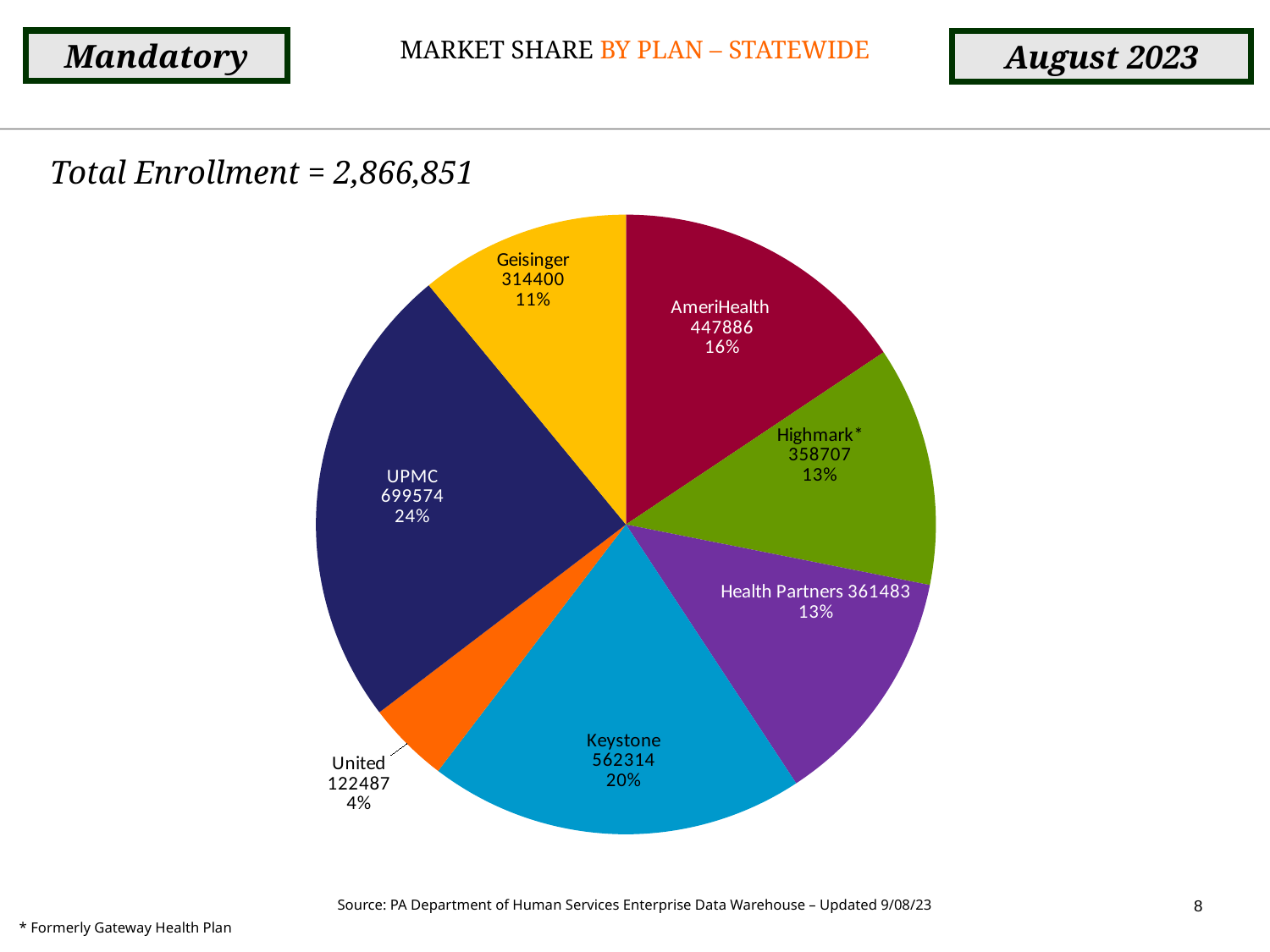
What total enrollment figure is stated above the chart? 2,866,851 How many plans (slices) are shown in the pie chart? 7 What is the difference between the enrollment values for UPMC and Keystone? 137260 What percentage share of the pie does Geisinger have? 11% What percentage share of the pie does AmeriHealth have? 16% Which plan has the largest share of the pie? UPMC What is the enrollment value shown for UPMC? 699574 Which has a larger enrollment value, Keystone or AmeriHealth? Keystone What is the enrollment value shown for Health Partners? 361483 What is the enrollment value shown for Keystone? 562314 Which plan has the smallest share of the pie? United What kind of chart is shown on the slide? pie chart